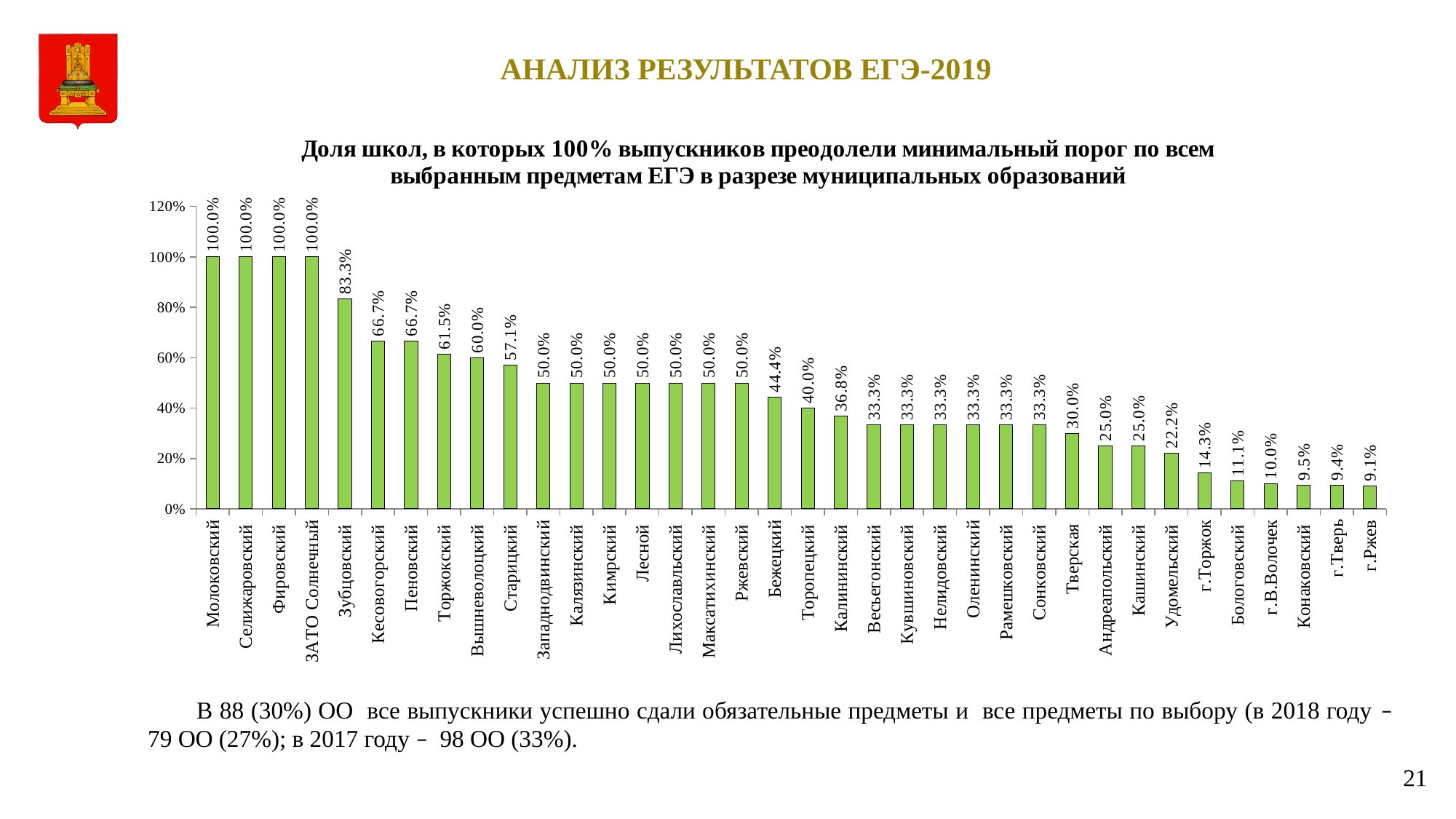
How many municipalities have a value of 100.0%? 4 What is the value for Торжокский? 61.5% What is the value for Зубцовский? 83.3% Is the value for Тверская greater or less than 40%? less What is the value for Бежецкий? 44.4% What is the difference between the values for Кесовогорский and Старицкий? 9.6% How many municipalities are shown on the x axis? 36 What kind of chart is shown on the slide? bar chart Do the values rise or fall from left to right along the x axis? fall What is the value for г.Тверь? 9.4% Which municipality has the lowest value on the chart? г.Ржев Which is larger, the value for Торопецкий or the value for Калининский? Торопецкий